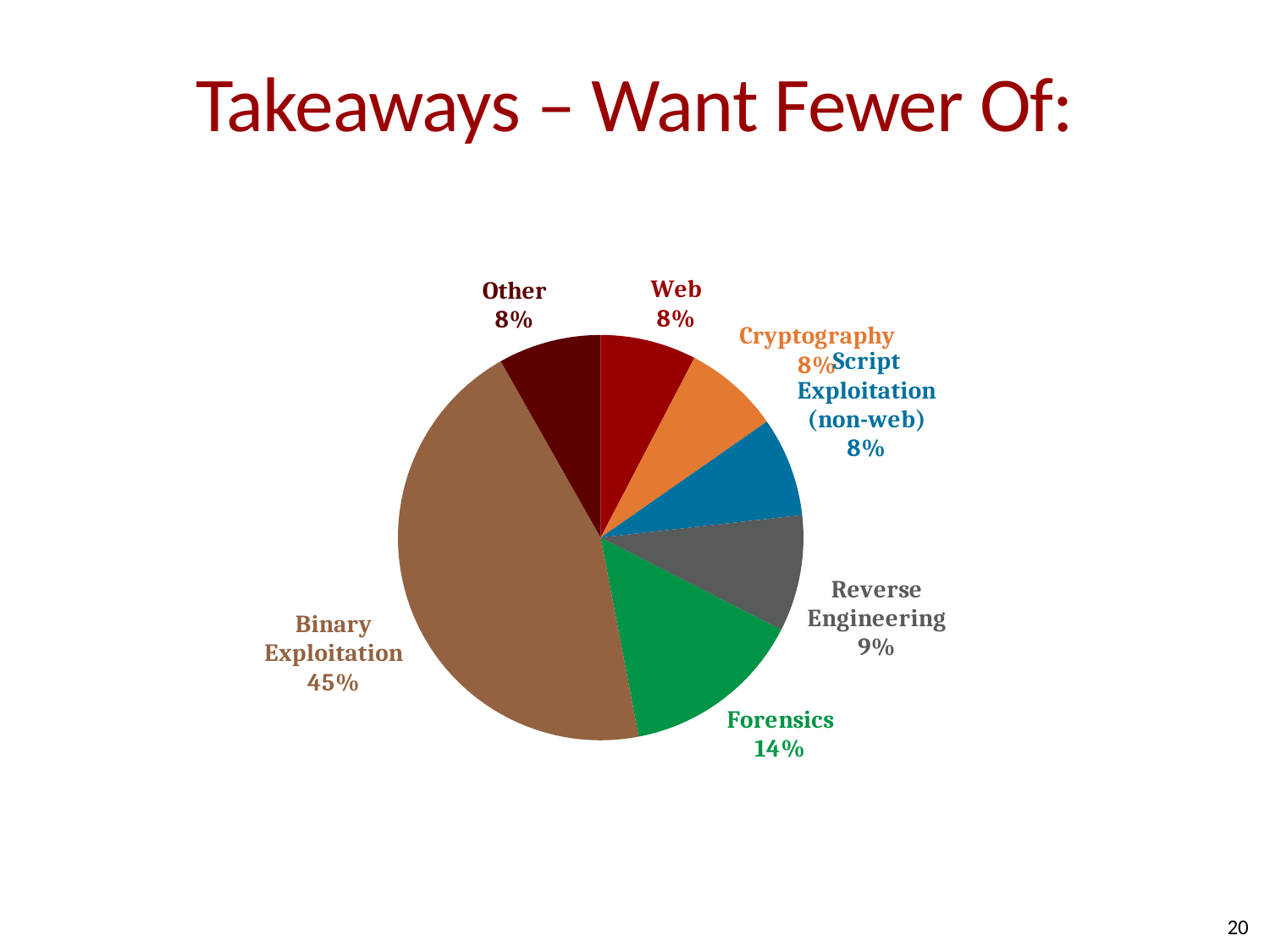
Which is larger, the Forensics slice or the Reverse Engineering slice? Forensics How many slices does the pie chart have? 7 What share of the pie does Web have? 8% What is the difference between the Binary Exploitation share and the Forensics share? 31% What kind of chart is shown on the slide? pie chart What is the title of the slide containing the pie chart? Takeaways – Want Fewer Of: What share of the pie does Forensics have? 14% What colour is the Forensics slice? green Which category has the largest slice of the pie? Binary Exploitation What share of the pie does Reverse Engineering have? 9% What is the difference between the Forensics share and the Reverse Engineering share? 5%